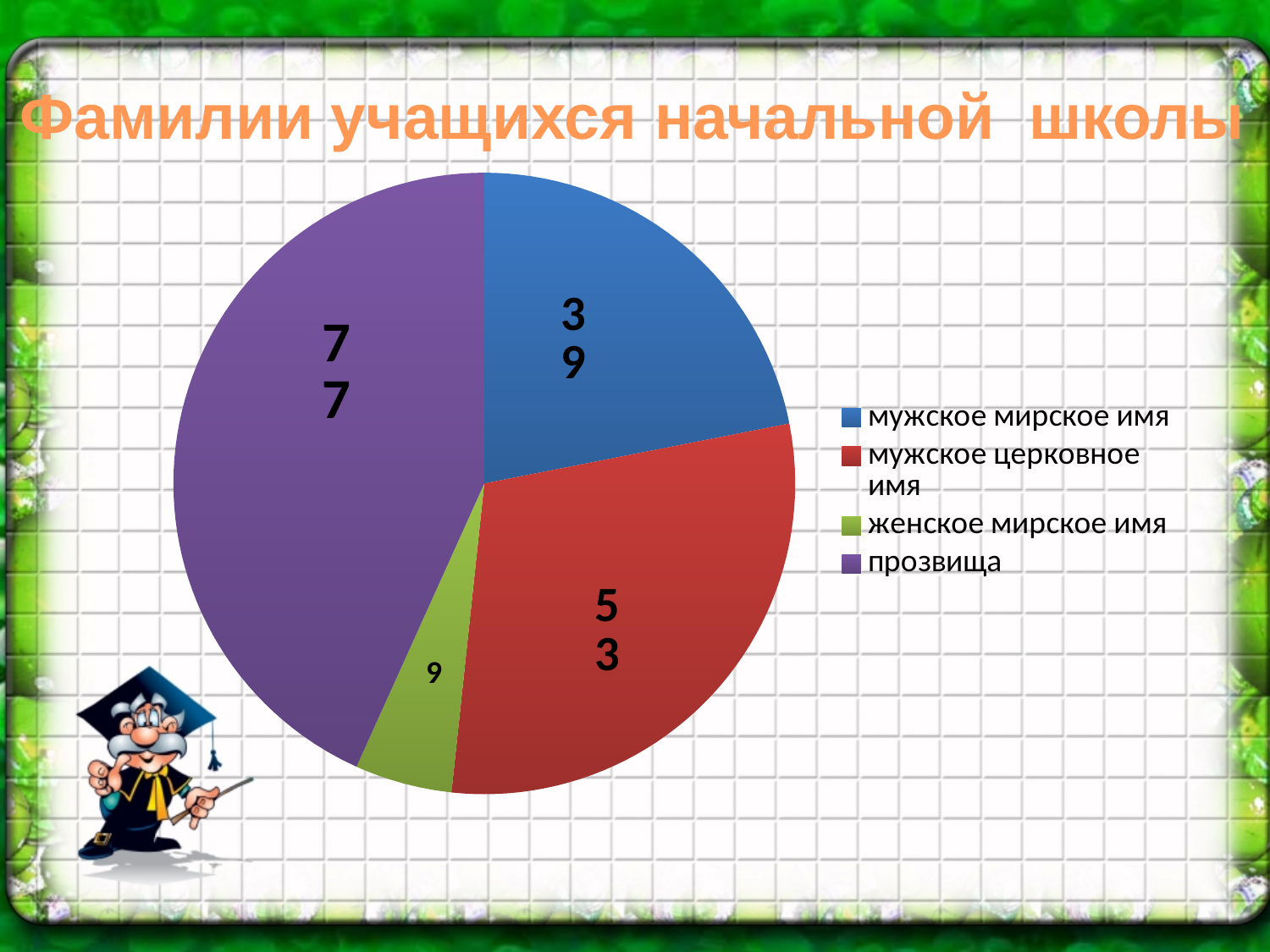
What is the value for женское мирское имя? 9 What is the value for прозвища? 77 What kind of chart is shown on the slide? pie chart What is the difference between the values for мужское церковное имя and мужское мирское имя? 14 Which category has the smallest slice of the pie? женское мирское имя What is the value for мужское церковное имя? 53 What is the title of the chart? Фамилии учащихся начальной школы What is the value for мужское мирское имя? 39 How many categories does the pie chart have? 4 Which is larger, the value for мужское церковное имя or the value for мужское мирское имя? мужское церковное имя Which category has the largest slice of the pie? прозвища What is the difference between the values for прозвища and мужское церковное имя? 24